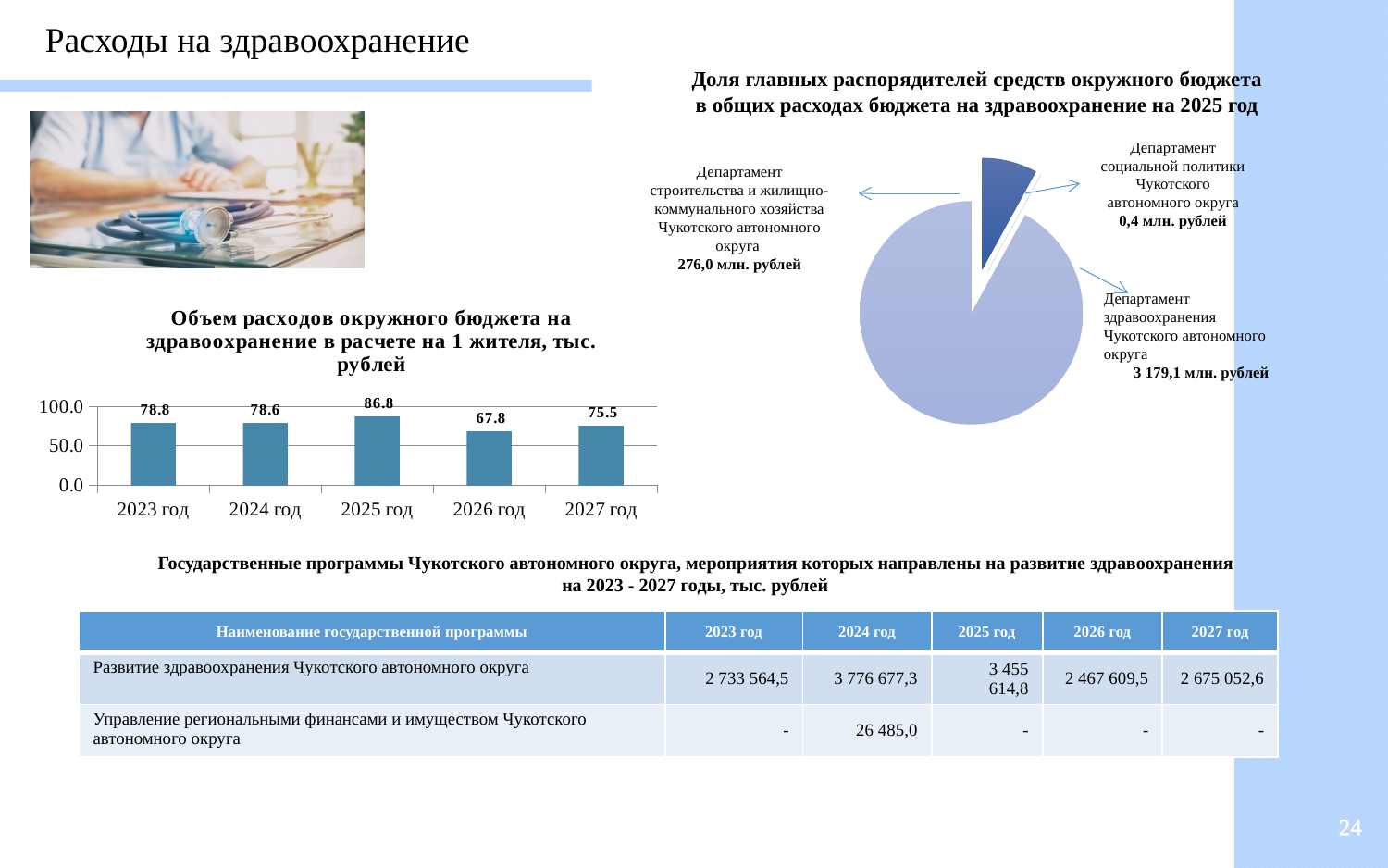
In the bar chart 'Объем расходов окружного бюджета на здравоохранение в расчете на 1 жителя', what is the value for 2025 год? 86.8 In the bar chart 'Объем расходов окружного бюджета на здравоохранение в расчете на 1 жителя', which year has the lowest value? 2026 год In the bar chart 'Объем расходов окружного бюджета на здравоохранение в расчете на 1 жителя', which year has the highest value? 2025 год What kind of chart is 'Объем расходов окружного бюджета на здравоохранение в расчете на 1 жителя'? Bar chart In the pie chart 'Доля главных распорядителей средств окружного бюджета в общих расходах бюджета на здравоохранение на 2025 год', what is the value for Департамент здравоохранения Чукотского автономного округа? 3 179,1 млн. рублей In the pie chart 'Доля главных распорядителей средств окружного бюджета в общих расходах бюджета на здравоохранение на 2025 год', which department has the smallest slice? Департамент социальной политики Чукотского автономного округа In the pie chart 'Доля главных распорядителей средств окружного бюджета в общих расходах бюджета на здравоохранение на 2025 год', what is the value for Департамент строительства и жилищно-коммунального хозяйства Чукотского автономного округа? 276,0 млн. рублей How many slices does the pie chart 'Доля главных распорядителей средств окружного бюджета в общих расходах бюджета на здравоохранение на 2025 год' have? 3 In the bar chart 'Объем расходов окружного бюджета на здравоохранение в расчете на 1 жителя', what is the difference between the values for 2025 год and 2026 год? 19.0 In the bar chart 'Объем расходов окружного бюджета на здравоохранение в расчете на 1 жителя', what is the value for 2026 год? 67.8 In the bar chart 'Объем расходов окружного бюджета на здравоохранение в расчете на 1 жителя', how many years are shown? 5 In the bar chart 'Объем расходов окружного бюджета на здравоохранение в расчете на 1 жителя', which is larger: the value for 2027 год or the value for 2026 год? 2027 год